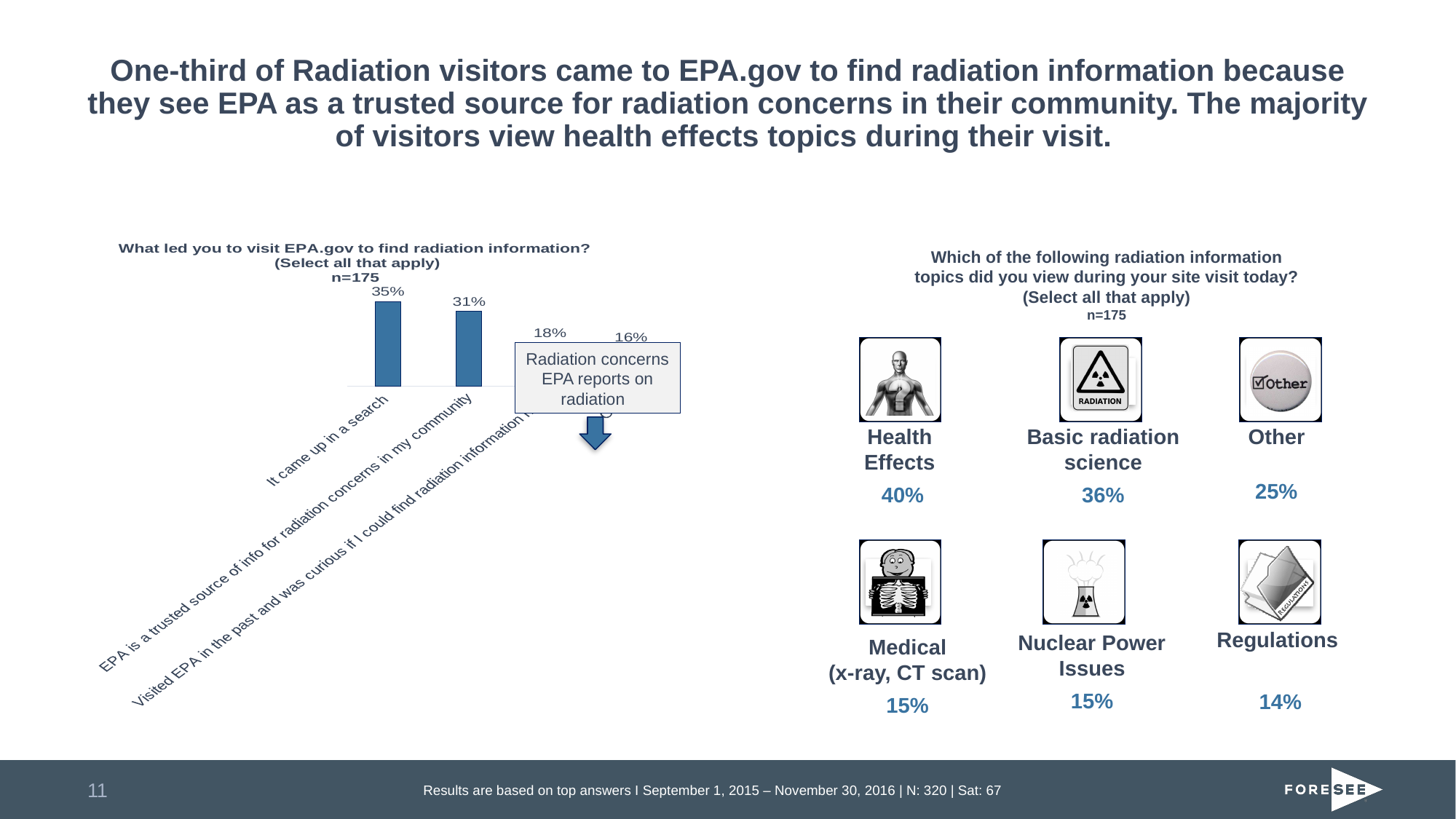
How many bars are shown in the bar chart? 4 Do the values in the bar chart rise or fall from left to right? Fall In the bar chart, which is larger: "It came up in a search" or "EPA is a trusted source of info for radiation concerns in my community"? It came up in a search In the bar chart, what percentage of visitors said EPA is a trusted source of info for radiation concerns in their community? 31% What is the sample size (n) stated in the bar chart's title? n=175 In the bar chart, what percentage of visitors said "It came up in a search" led them to visit EPA.gov? 35% In the bar chart, what is the difference between "It came up in a search" and "EPA is a trusted source of info for radiation concerns in my community"? 4 percentage points What type of chart is shown on the left of the slide? Bar chart In the bar chart, what percentage of visitors said they visited EPA in the past and were curious if they could find radiation information? 18% Which category has the highest value in the bar chart? It came up in a search In the bar chart, what is the difference between the highest value and the lowest value? 19 percentage points What is the lowest value shown in the bar chart? 16%